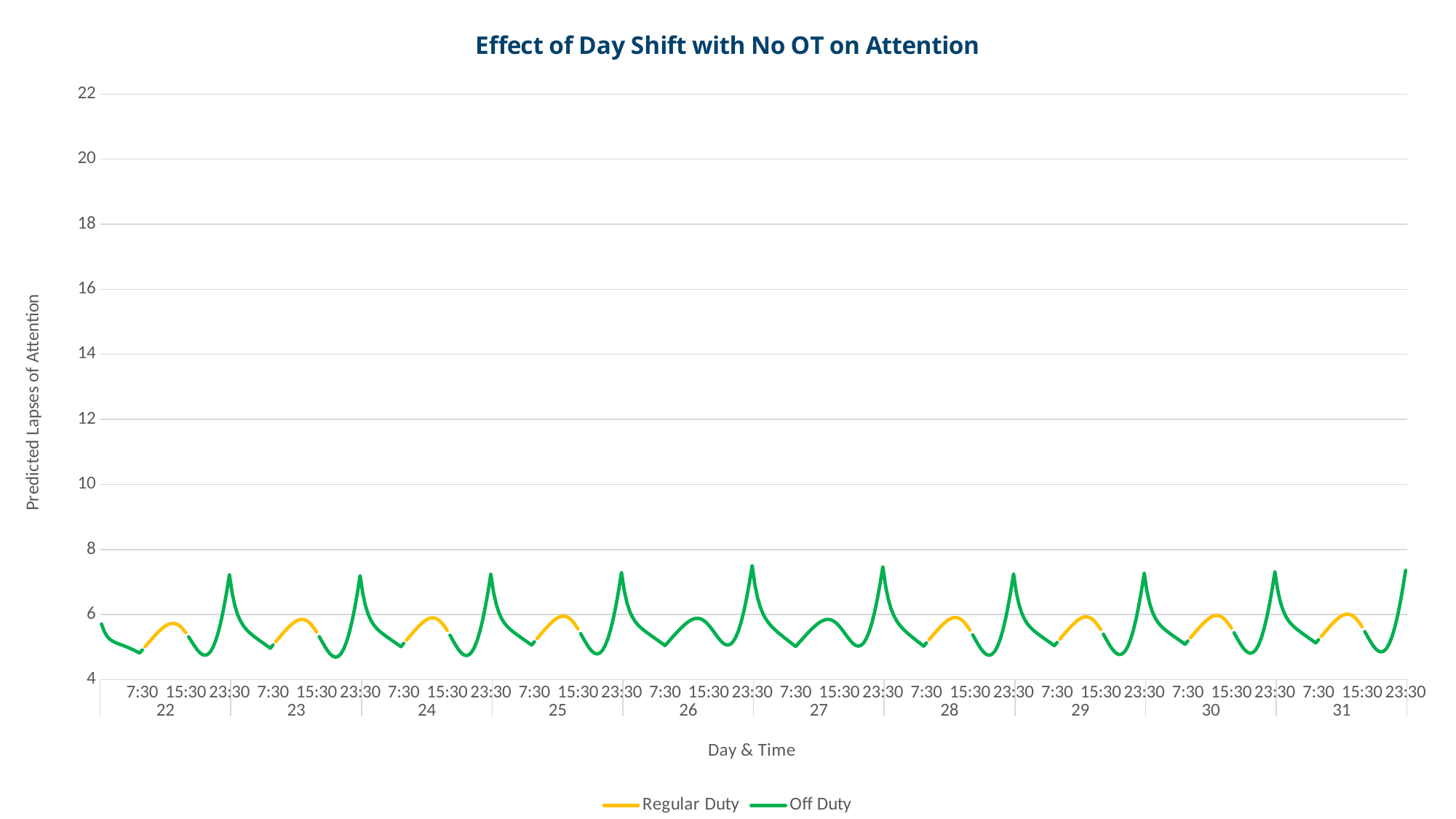
Is the Off Duty value at 23:30 on day 31 greater or less than 6? greater Is the Off Duty peak at 23:30 on day 26 greater or less than 8? less Which colour represents the Off Duty series in the chart? Green Does any plotted value on the chart exceed 10? No What kind of chart is shown on the slide? Line chart Which series reaches higher values on the chart, Regular Duty or Off Duty? Off Duty What is the title of the chart? Effect of Day Shift with No OT on Attention How many series does the legend list? 2 How many days are labelled along the x axis of the chart? 10